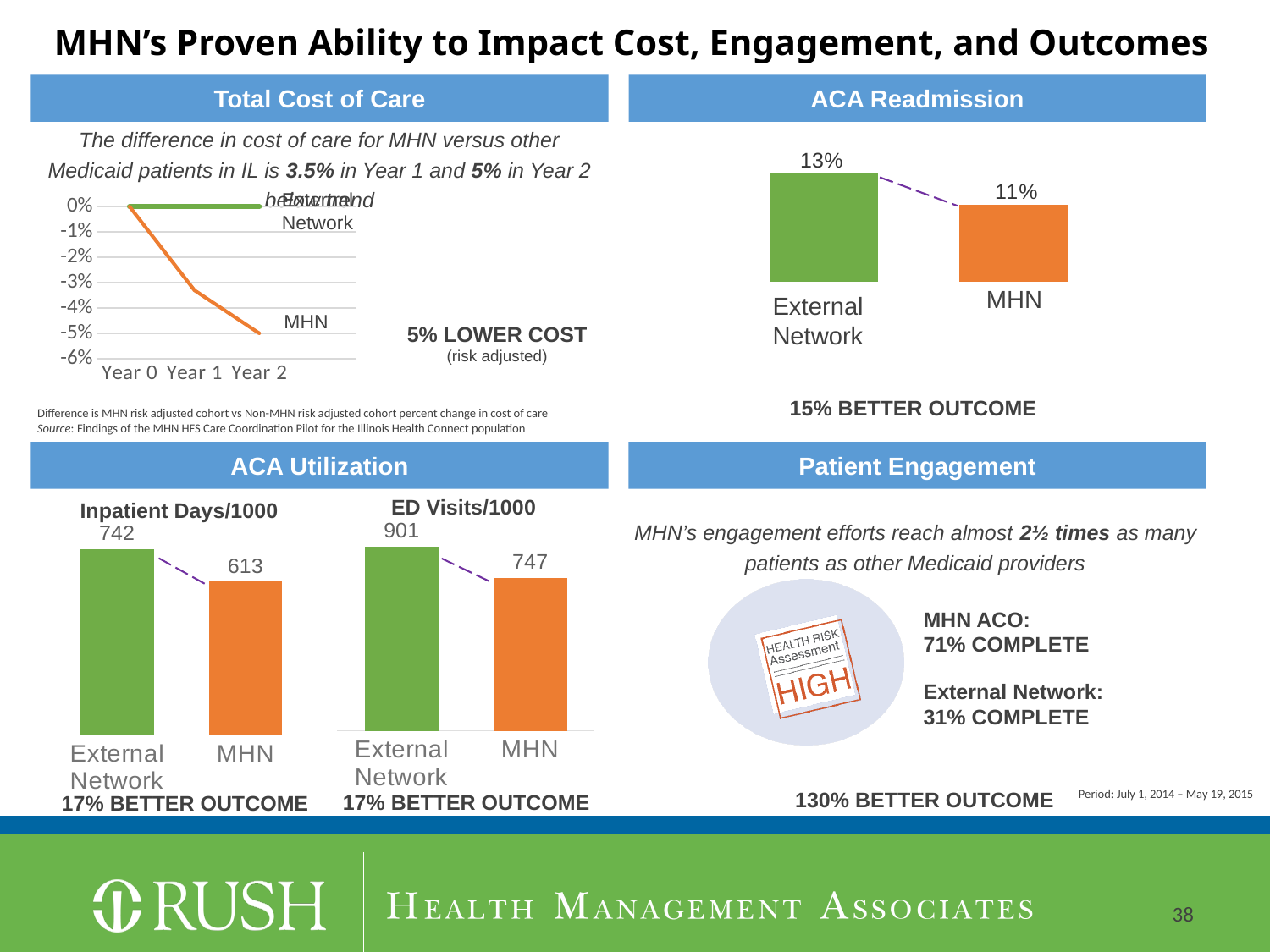
In the Inpatient Days/1000 chart, what is the value for MHN? 613 What kind of chart is shown under Total Cost of Care? Line chart In the ACA Readmission chart, what is the difference between the External Network and MHN values? 2% In the ED Visits/1000 chart, what is the difference between External Network and MHN? 154 In the ACA Readmission chart, what is the value for External Network? 13% In the Inpatient Days/1000 chart, what is the difference between External Network and MHN? 129 In the ED Visits/1000 chart, which category has the lower value? MHN In the ED Visits/1000 chart, what is the value for External Network? 901 In the Total Cost of Care chart, is the MHN value at Year 2 greater or less than -4%? less In the ACA Readmission chart, what is the value for MHN? 11% In the Total Cost of Care chart, does the MHN line rise or fall from Year 0 to Year 2? Fall In the Inpatient Days/1000 chart, what is the value for External Network? 742